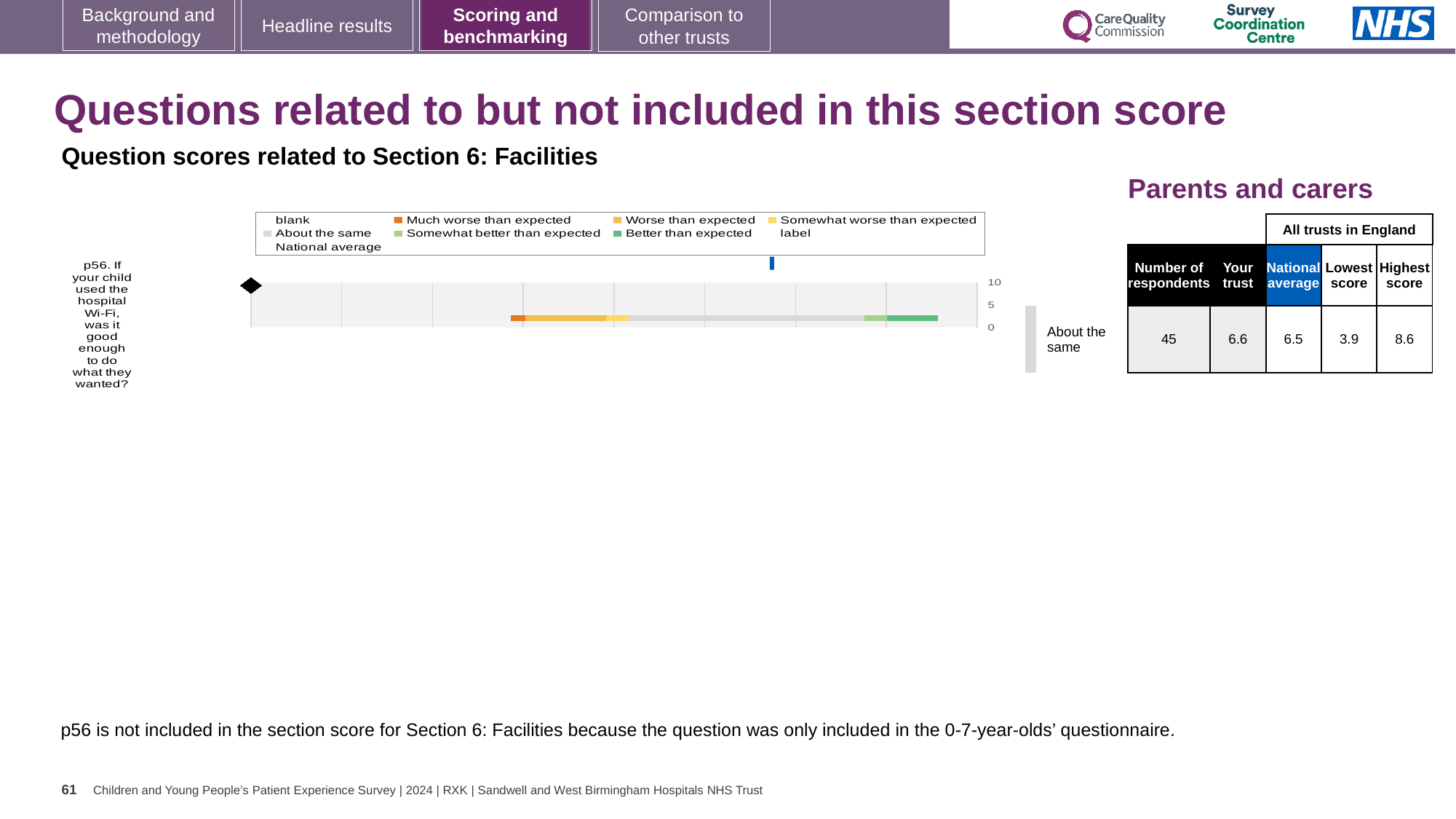
What is the national average score for question p56? 6.5 What kind of chart is shown for question p56? bar chart Which is larger for question p56, the 'Your trust' score or the national average? Your trust What benchmark category is the trust's result for p56 placed in? About the same What is the highest score among all trusts in England for question p56? 8.6 What is the highest value shown on the chart's score axis? 10 What is the number of respondents for question p56 about hospital Wi-Fi? 45 What is the difference between the highest and lowest scores for question p56? 4.7 How many survey questions are plotted in the chart? 1 What is the 'Your trust' score for question p56? 6.6 What is the difference between the 'Your trust' score and the national average for question p56? 0.1 What is the lowest score among all trusts in England for question p56? 3.9